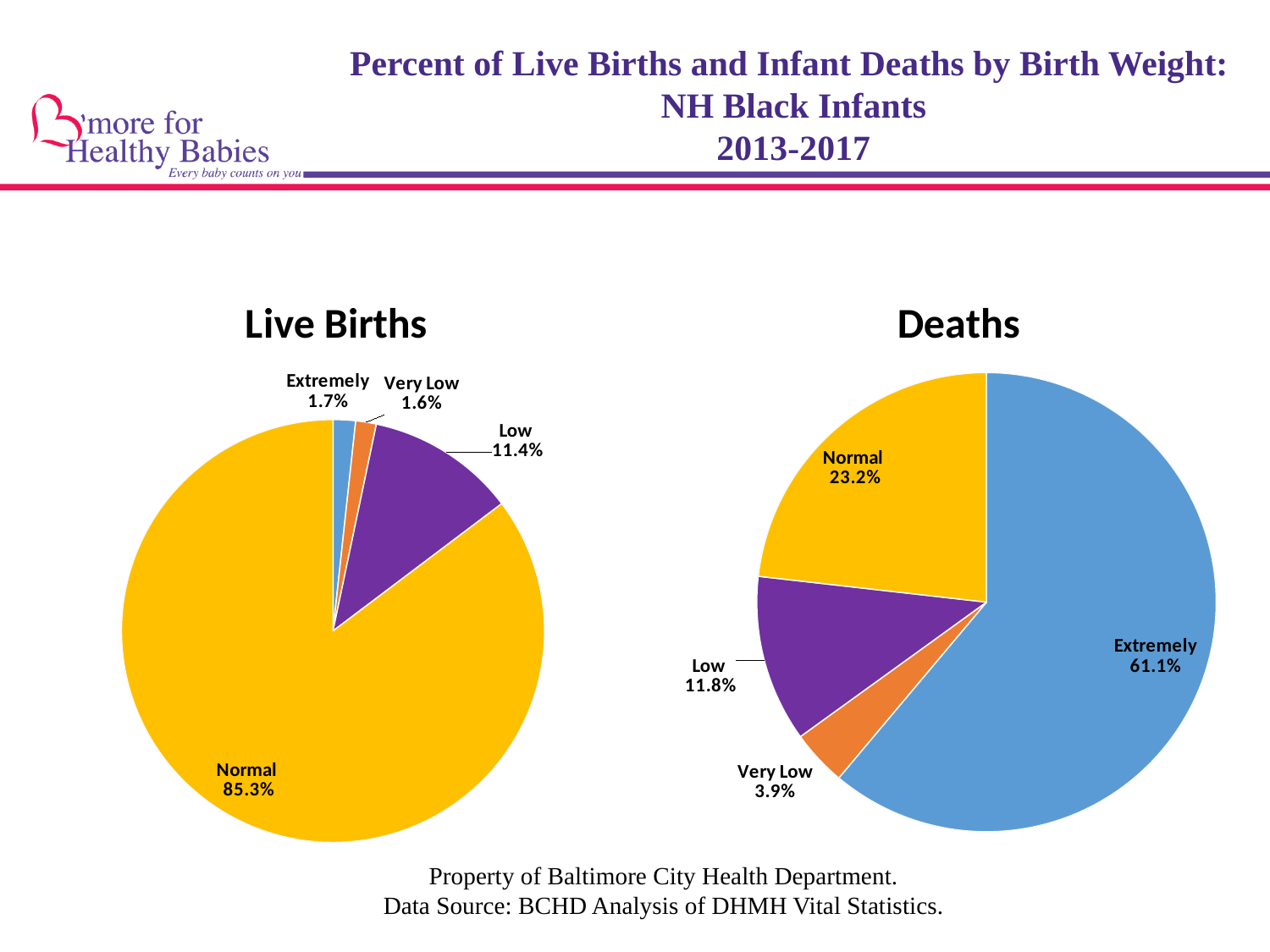
In the Deaths pie chart, which category has the largest slice? Extremely Which is larger: the Low share in the Live Births chart or the Low share in the Deaths chart? Deaths (11.8%) What type of chart is used for the Deaths data? Pie chart What colour is the Normal slice in both pie charts? Yellow In the Live Births pie chart, what percentage is labelled for Low birth weight? 11.4% In the Deaths pie chart, what is the difference between the Extremely and Normal percentages? 37.9% In the Deaths pie chart, what percentage is labelled for Extremely low birth weight? 61.1% How many slices does the Live Births pie chart have? 4 In the Deaths pie chart, what percentage is labelled for Very Low birth weight? 3.9% In the Live Births pie chart, what percentage is labelled for Normal birth weight? 85.3% In the Live Births pie chart, which category has the largest slice? Normal In the Deaths pie chart, which category has the smallest slice? Very Low